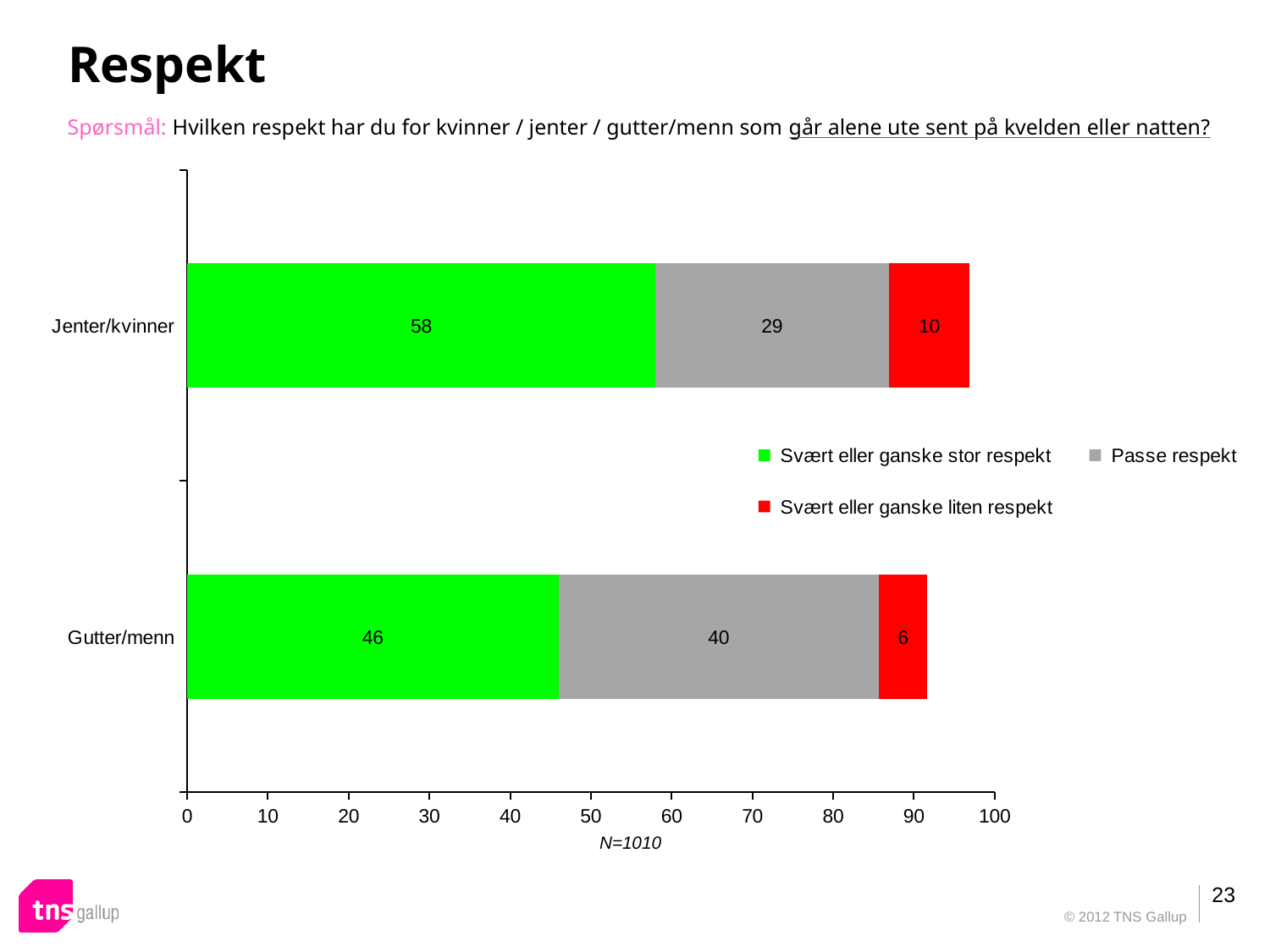
What is the value for 'Svært eller ganske stor respekt' for Jenter/kvinner? 58 What kind of chart is shown on the slide? Stacked bar chart What is the total of the stacked bar for Jenter/kvinner? 97 How many series does the legend list? 3 What is the total of the stacked bar for Gutter/menn? 92 What is the difference between the 'Passe respekt' values for Gutter/menn and Jenter/kvinner? 11 What is the value for 'Svært eller ganske stor respekt' for Gutter/menn? 46 Is the 'Passe respekt' value larger for Jenter/kvinner or Gutter/menn? Gutter/menn Which category has the higher value for 'Svært eller ganske stor respekt'? Jenter/kvinner Which category has the lower value for 'Svært eller ganske liten respekt'? Gutter/menn What is the value for 'Svært eller ganske liten respekt' for Jenter/kvinner? 10 What is the value for 'Passe respekt' for Gutter/menn? 40